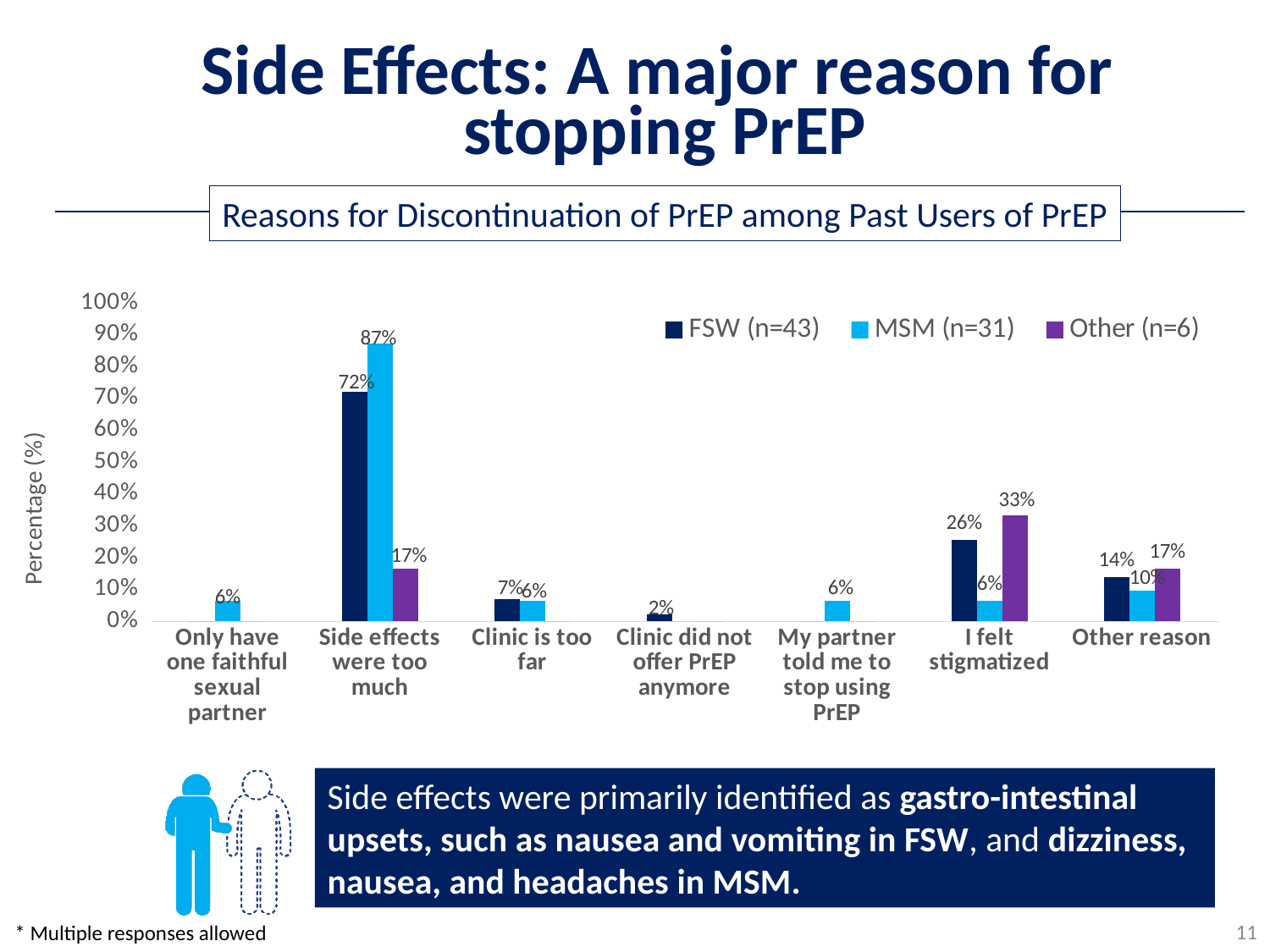
What kind of chart is shown on the slide? Bar chart For 'I felt stigmatized', which group has the larger value, FSW or Other? Other What is the sample size for the MSM group shown in the legend? n=31 Which reason has the highest value for the MSM series? Side effects were too much What percentage of FSW reported 'Side effects were too much' as a reason for discontinuing PrEP? 72% What is the difference between the MSM and FSW values for 'Side effects were too much'? 15 percentage points What is the value for the Other group for 'I felt stigmatized'? 33% Is the FSW value for 'I felt stigmatized' greater or less than 30%? less What percentage of MSM reported 'Side effects were too much'? 87% What percentage of FSW reported 'Other reason'? 14% How many reason categories are shown on the x axis? 7 How many series does the legend list? 3